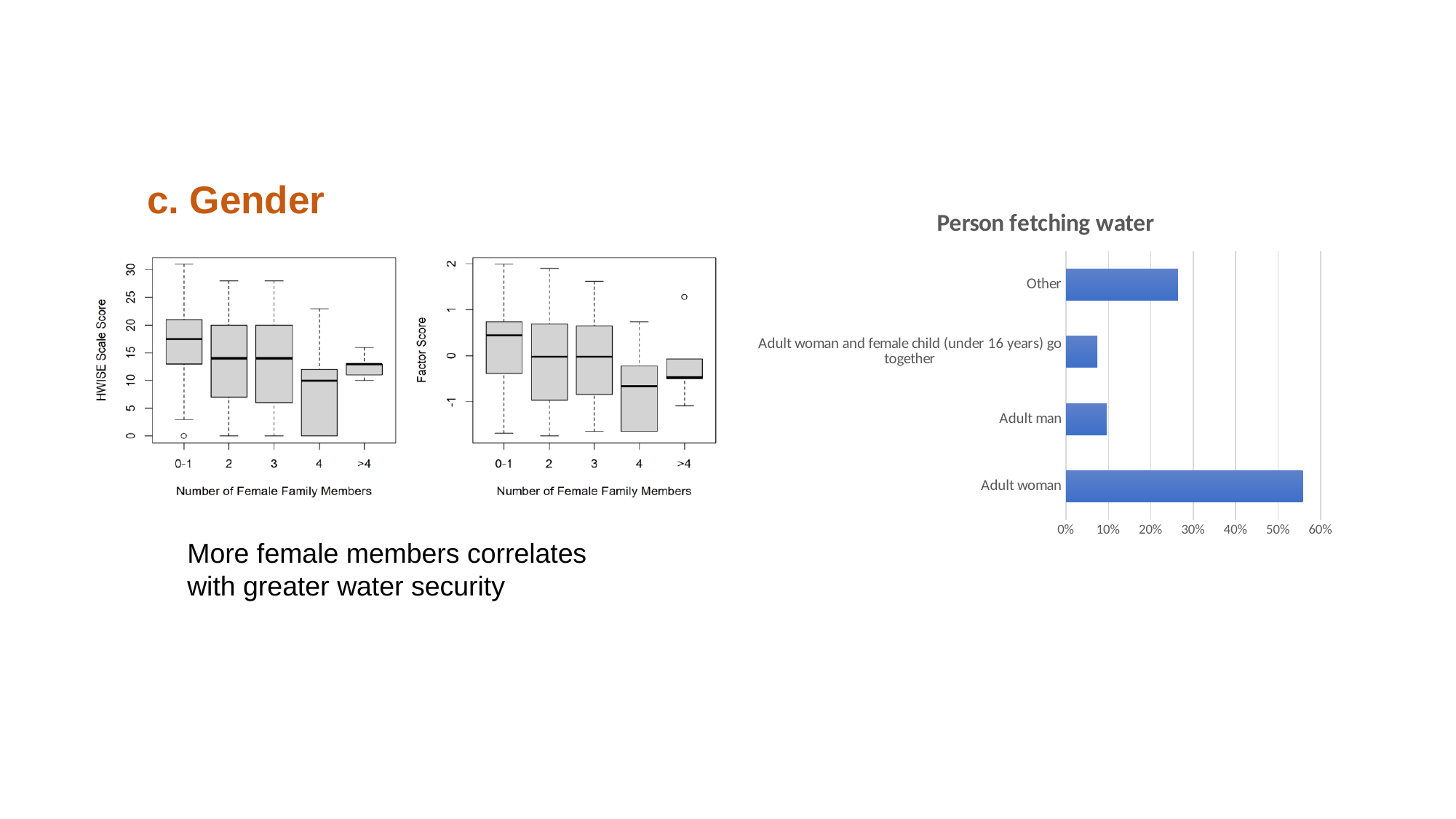
In the 'Person fetching water' chart, which is larger: the value for Other or the value for Adult man? Other In the 'Person fetching water' chart, is the value for 'Adult woman and female child (under 16 years) go together' greater or less than 10%? less In the 'Person fetching water' chart, is the value for Other greater or less than 20%? greater In the 'Person fetching water' chart, what is the highest value shown on the horizontal axis? 60% What is the x-axis label of the middle chart with the y-axis 'Factor Score'? Number of Female Family Members In the 'Person fetching water' chart, which category has the highest value? Adult woman In the 'Person fetching water' chart, is the value for Adult woman greater or less than 50%? greater What type of chart is the 'Person fetching water' chart? bar chart In the leftmost chart with the y-axis 'HWISE Scale Score', how many categories are shown on the x-axis? 5 What type of chart is the leftmost chart with the y-axis 'HWISE Scale Score'? box plot In the 'Person fetching water' chart, how many categories are shown? 4